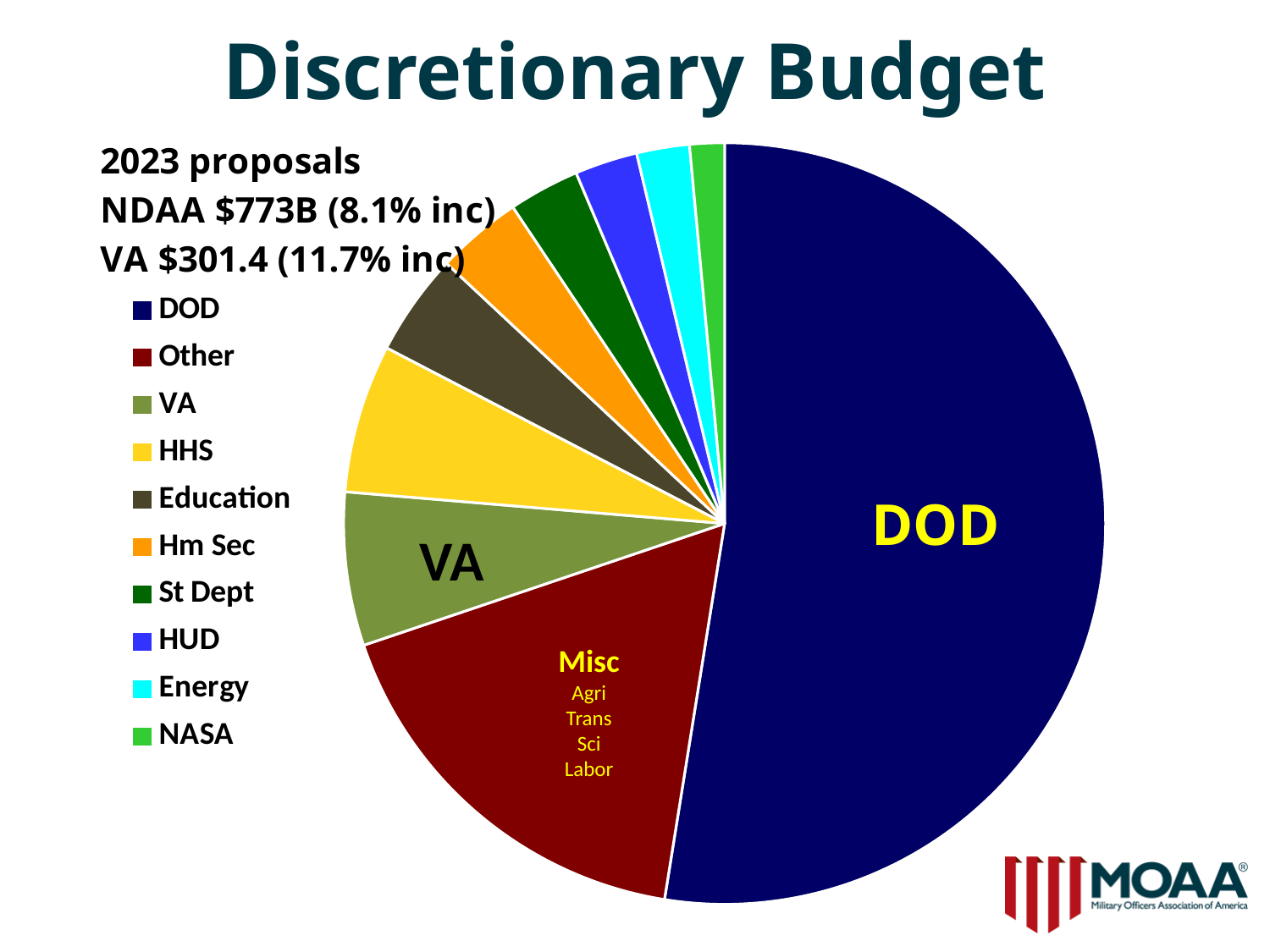
What colour is the DOD slice of the pie chart? dark navy blue Which slice is larger, Other or VA? Other Which category is listed last in the legend? NASA What kind of chart is shown on the slide? pie chart What is the title of the chart? Discretionary Budget Which category has the largest slice of the pie chart? DOD Which slice is larger, HHS or HUD? HHS How many categories does the legend of the pie chart list? 10 Which slice is larger, DOD or Other? DOD